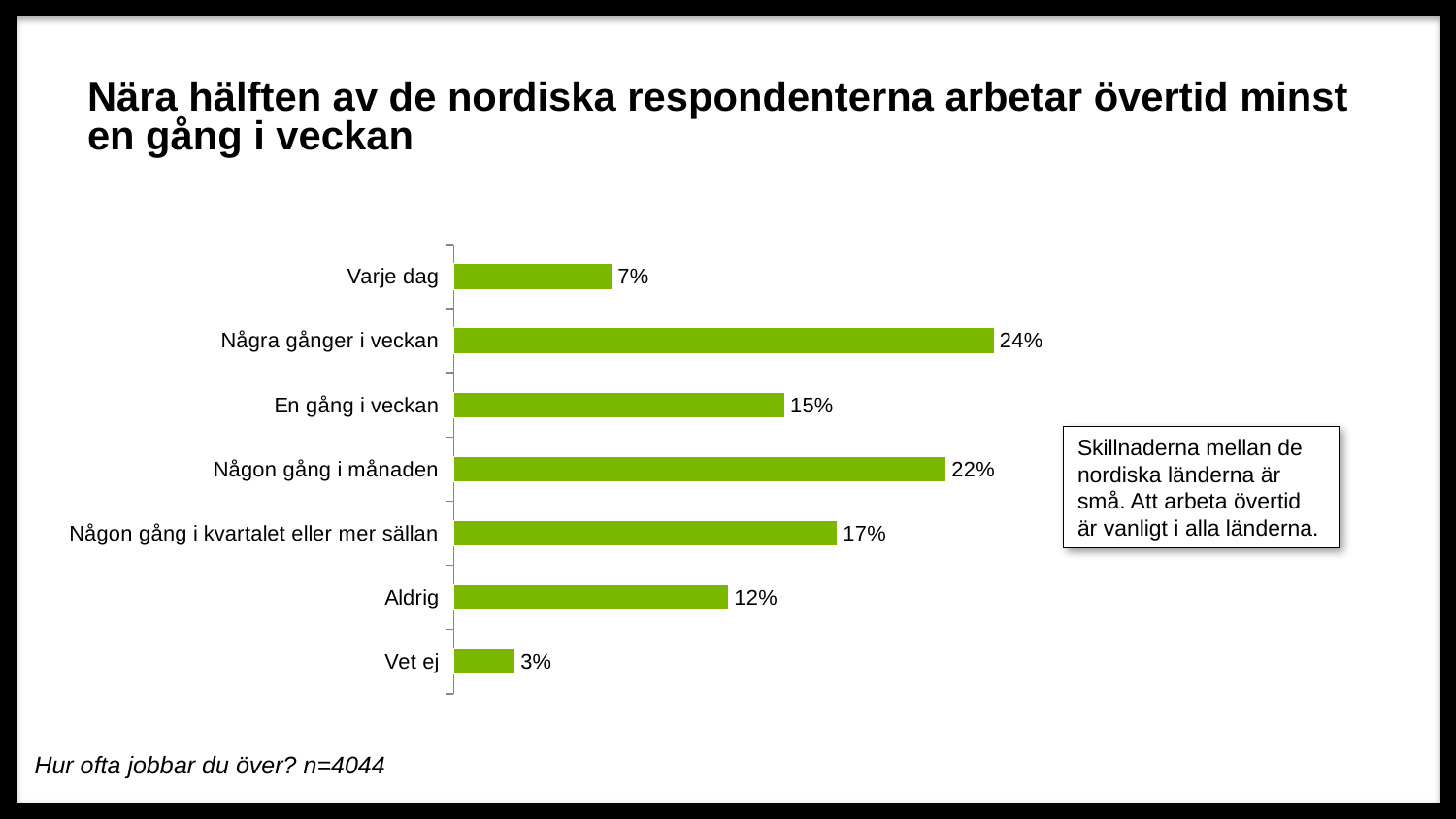
Which is larger, the value for "Någon gång i månaden" or the value for "Någon gång i kvartalet eller mer sällan"? Någon gång i månaden Which category has the lowest value? Vet ej How many categories are shown in the chart? 7 What is the difference between "Någon gång i månaden" and "Varje dag"? 15% Which is larger, the value for "Varje dag" or the value for "Aldrig"? Aldrig What kind of chart is shown on the slide? Bar chart What is the value for "Aldrig"? 12% What is the value for "Någon gång i kvartalet eller mer sällan"? 17% Which category has the highest value? Några gånger i veckan What is the value for "Några gånger i veckan"? 24% What is the difference between "Några gånger i veckan" and "En gång i veckan"? 9% What colour are the bars in the chart? Green